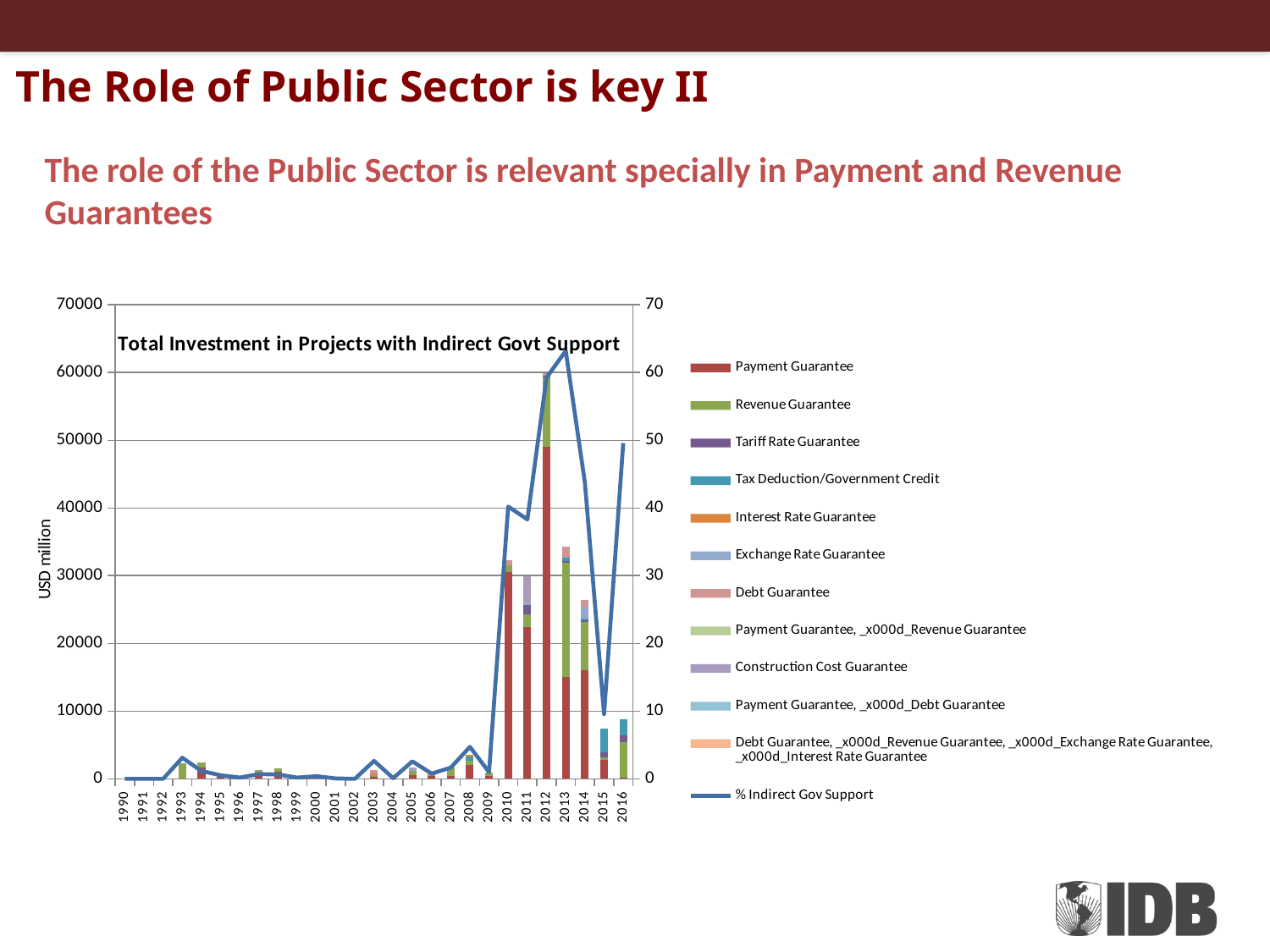
Is the % Indirect Gov Support line value for 2016 greater or less than 40? greater How many series does the chart's legend list? 12 Does the % Indirect Gov Support line rise or fall from 2013 to 2015? fall Which year has the larger total stacked bar, 2012 or 2013? 2012 How many years are shown along the x axis of the chart? 27 What is the title of the chart? Total Investment in Projects with Indirect Govt Support Is the total stacked bar for 2012 greater or less than 50000? greater Is the total stacked bar for 2015 greater or less than 10000? less What is the label on the left vertical axis of the chart? USD million Which year has the tallest stacked bar in the chart? 2012 What kind of chart is shown on the slide? A combined bar and line chart (stacked bars with a line)